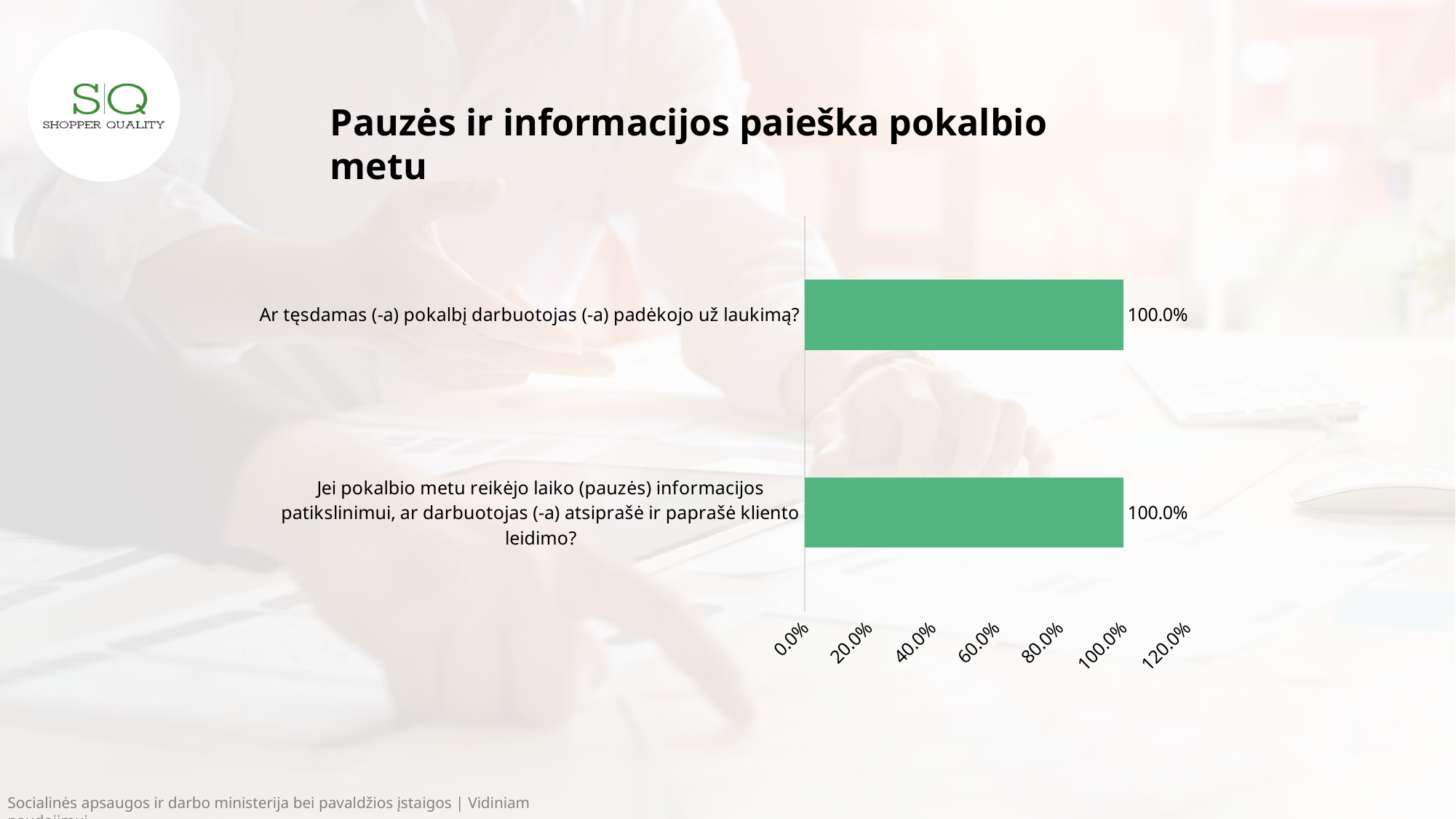
How many categories are plotted in the chart? 2 What kind of chart is shown on the slide? Bar chart Is the value for "Ar tęsdamas (-a) pokalbį darbuotojas (-a) padėkojo už laukimą?" greater or less than 80.0%? greater What is the difference between the two plotted values? 0.0% What is the highest tick label shown on the value axis? 120.0% Is the value for "Jei pokalbio metu reikėjo laiko (pauzės) informacijos patikslinimui, ar darbuotojas (-a) atsiprašė ir paprašė kliento leidimo?" greater or less than 60.0%? greater What is the value for "Jei pokalbio metu reikėjo laiko (pauzės) informacijos patikslinimui, ar darbuotojas (-a) atsiprašė ir paprašė kliento leidimo?"? 100.0% What is the title of the slide containing the chart? Pauzės ir informacijos paieška pokalbio metu What is the value for "Ar tęsdamas (-a) pokalbį darbuotojas (-a) padėkojo už laukimą?"? 100.0%